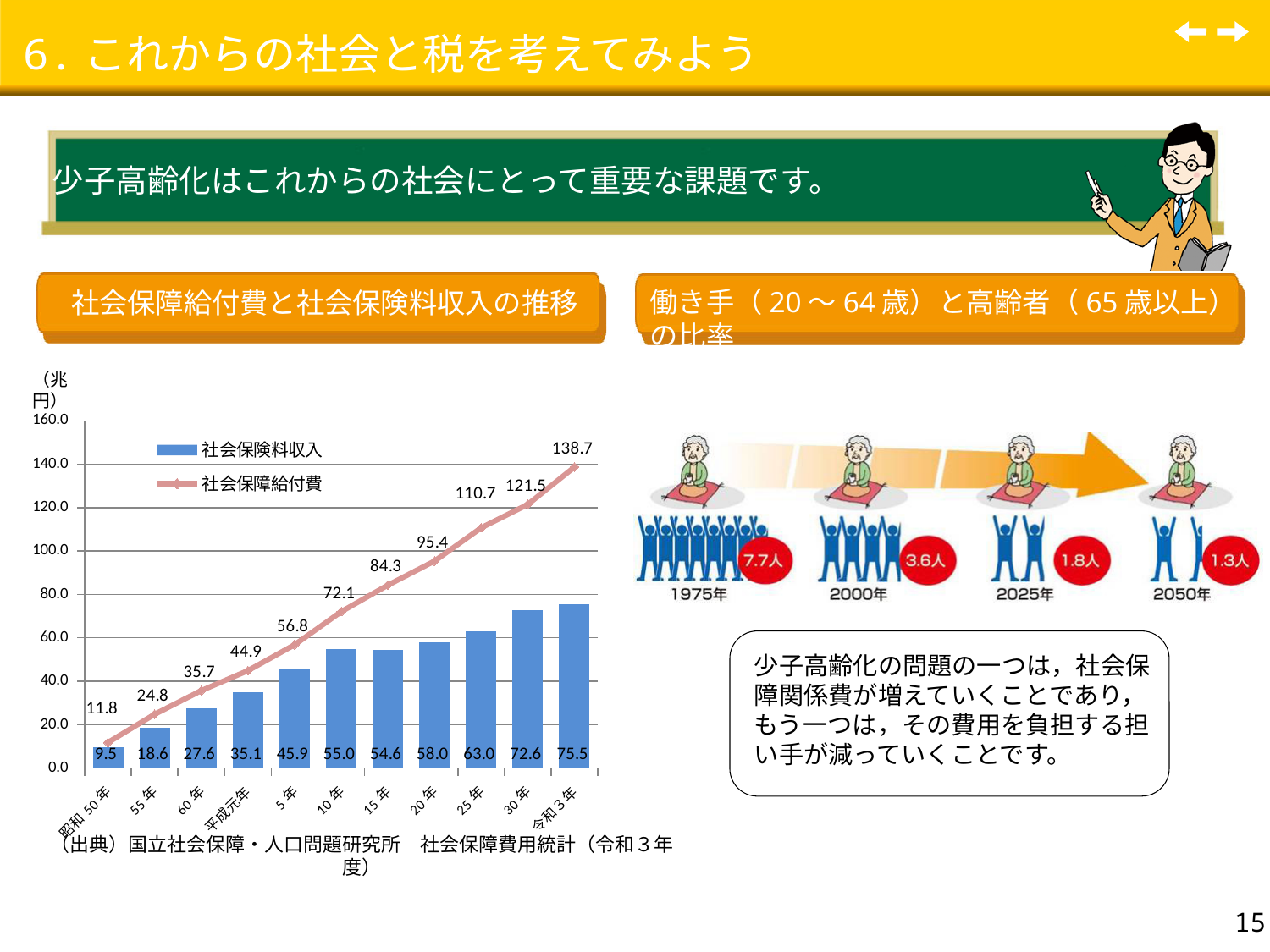
What is the value of 社会保障給付費 for 平成元年? 44.9 What is the difference between 社会保障給付費 and 社会保険料収入 in 令和3年? 63.2 Which is larger in 平成15年: 社会保険料収入 or 社会保障給付費? 社会保障給付費 Which year has the lowest 社会保険料収入? 昭和50年 What kind of chart is used for 社会保険料収入? bar chart How many series does the chart legend list? 2 How many years are shown on the x axis of the chart? 11 Which year has the highest 社会保障給付費? 令和3年 What is the value of 社会保険料収入 for 昭和50年? 9.5 What is the value of 社会保険料収入 for 令和3年? 75.5 What unit is shown on the vertical axis of the chart? 兆円 Does 社会保障給付費 rise or fall from 昭和50年 to 令和3年? rise